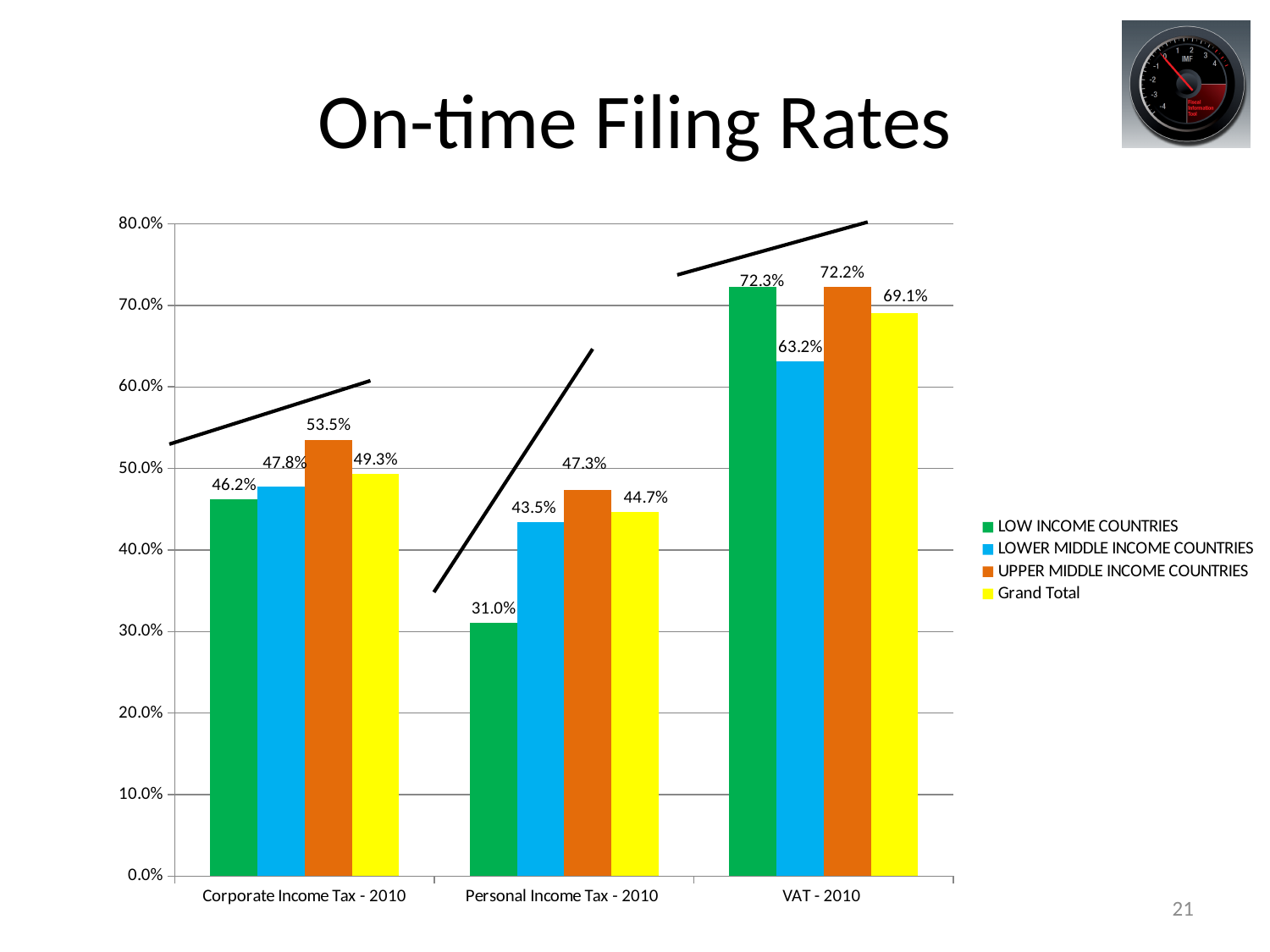
What colour are the Grand Total bars? yellow Which series has the highest value for Corporate Income Tax - 2010? UPPER MIDDLE INCOME COUNTRIES How many series does the legend list? 4 What kind of chart is shown on the slide? bar chart Which is larger for Personal Income Tax - 2010: LOWER MIDDLE INCOME COUNTRIES or Grand Total? Grand Total Which series has the lowest value for VAT - 2010? LOWER MIDDLE INCOME COUNTRIES What is the Grand Total value for VAT - 2010? 69.1% Is the LOWER MIDDLE INCOME COUNTRIES value for VAT - 2010 greater or less than 60.0%? greater What is the on-time filing rate for LOW INCOME COUNTRIES for Personal Income Tax - 2010? 31.0% How many tax categories are shown on the x axis? 3 What is the difference between the UPPER MIDDLE INCOME COUNTRIES and LOW INCOME COUNTRIES values for Personal Income Tax - 2010? 16.3% What is the value for UPPER MIDDLE INCOME COUNTRIES for Corporate Income Tax - 2010? 53.5%